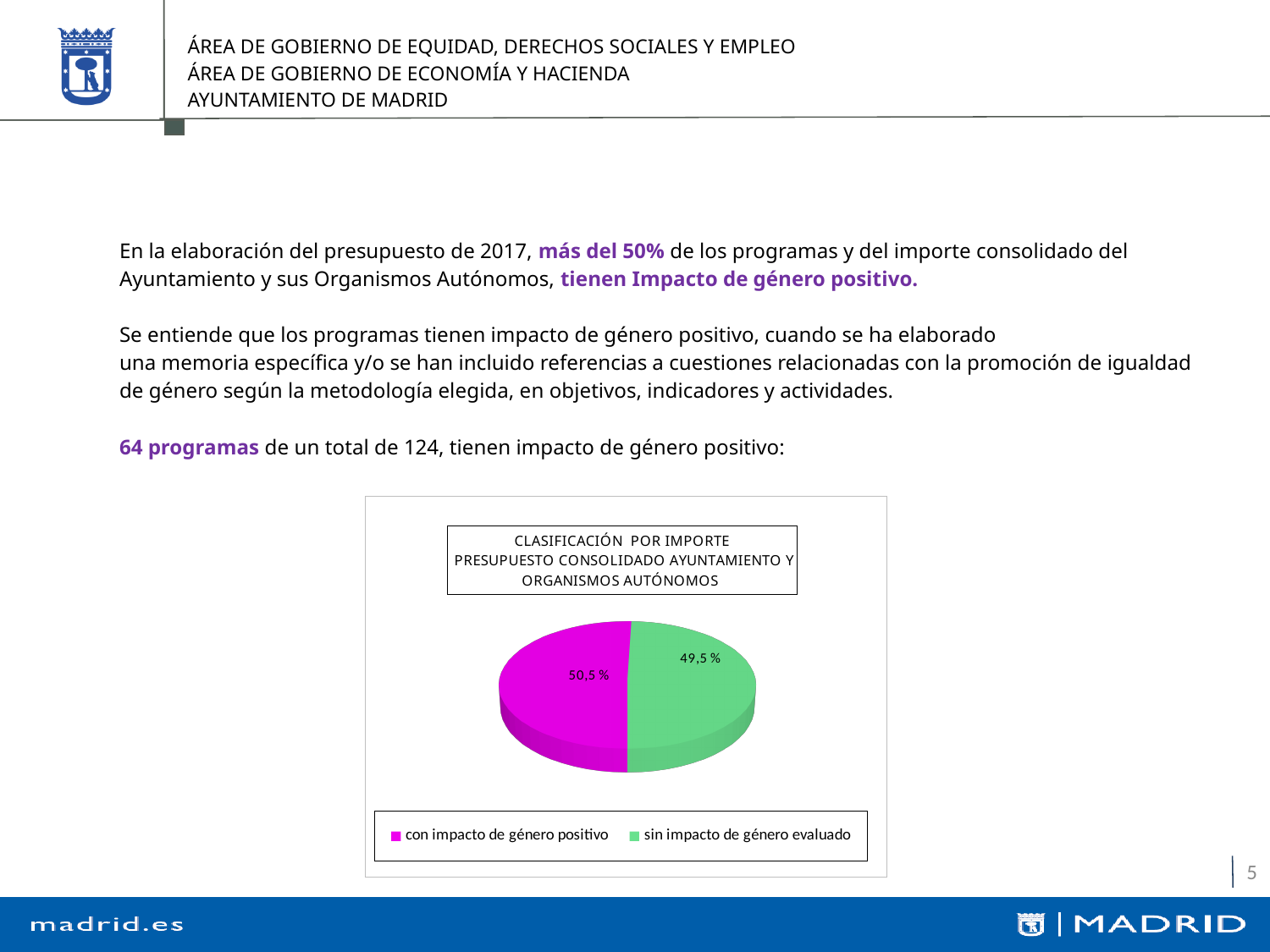
What is the title of the chart? CLASIFICACIÓN POR IMPORTE PRESUPUESTO CONSOLIDADO AYUNTAMIENTO Y ORGANISMOS AUTÓNOMOS Which is larger: "con impacto de género positivo" or "sin impacto de género evaluado"? con impacto de género positivo What is the difference between the "con impacto de género positivo" and "sin impacto de género evaluado" slices? 1 % What colour is the "sin impacto de género evaluado" slice? green Which slice is the smallest? sin impacto de género evaluado What kind of chart is shown on the slide? pie chart How many slices does the pie chart have? 2 Which slice is the largest? con impacto de género positivo What is the value for "con impacto de género positivo"? 50,5 % What is the value for "sin impacto de género evaluado"? 49,5 % What share of the pie does "con impacto de género positivo" represent? 50,5 % How many entries does the legend list? 2